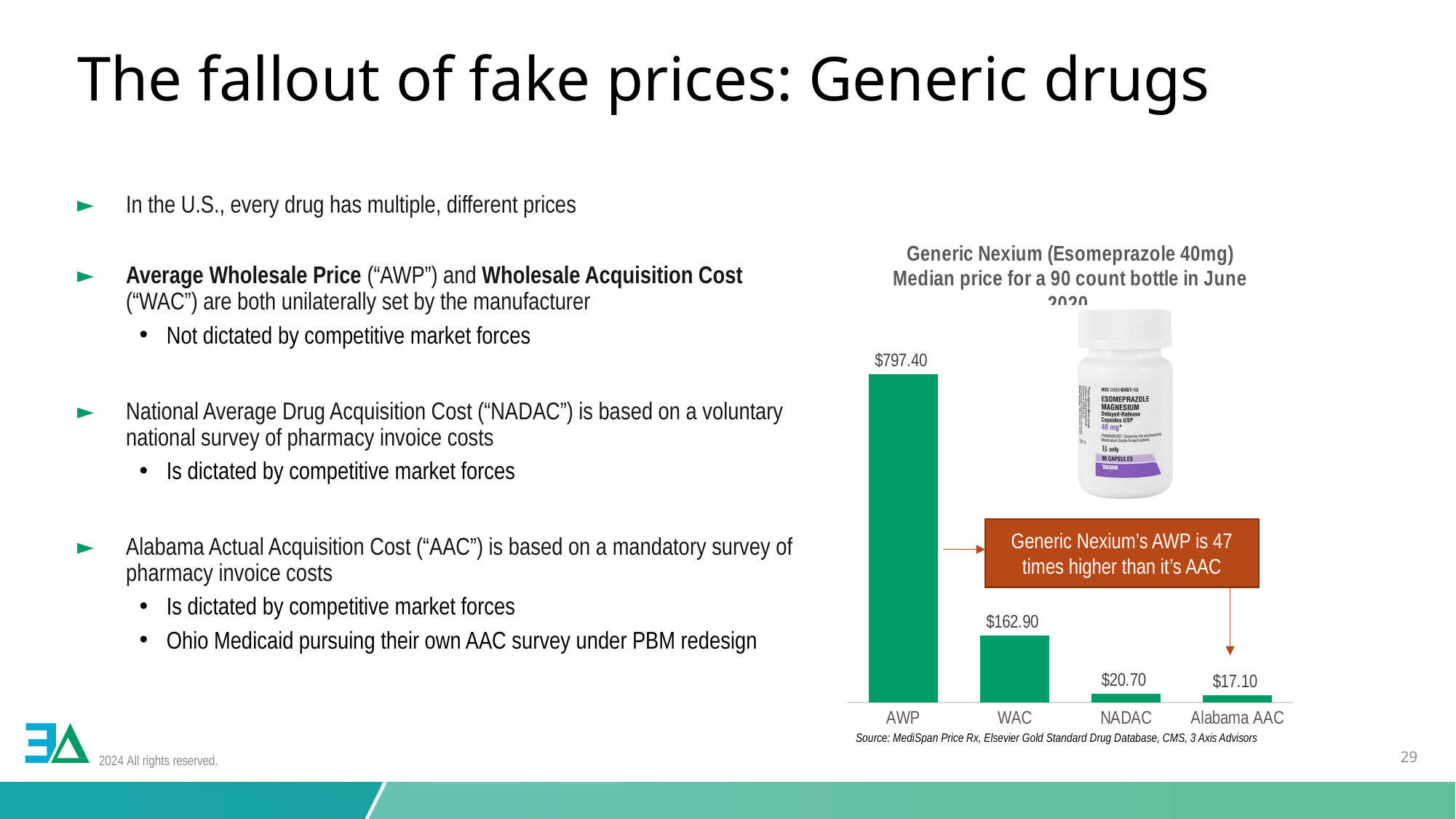
How many price categories are plotted in the chart? 4 What is the median price shown for AWP? $797.40 Which price category has the lowest value in the chart? Alabama AAC What is the median price shown for WAC? $162.90 What is the difference between the AWP price and the WAC price? $634.50 Which price category has the highest value in the chart? AWP What is the median price shown for Alabama AAC? $17.10 What is the median price shown for NADAC? $20.70 According to the callout box on the chart, how many times higher is Generic Nexium's AWP than its AAC? 47 times Which is larger, the WAC price or the NADAC price? WAC What is the difference between the NADAC price and the Alabama AAC price? $3.60 What type of chart is shown on the slide? Bar chart